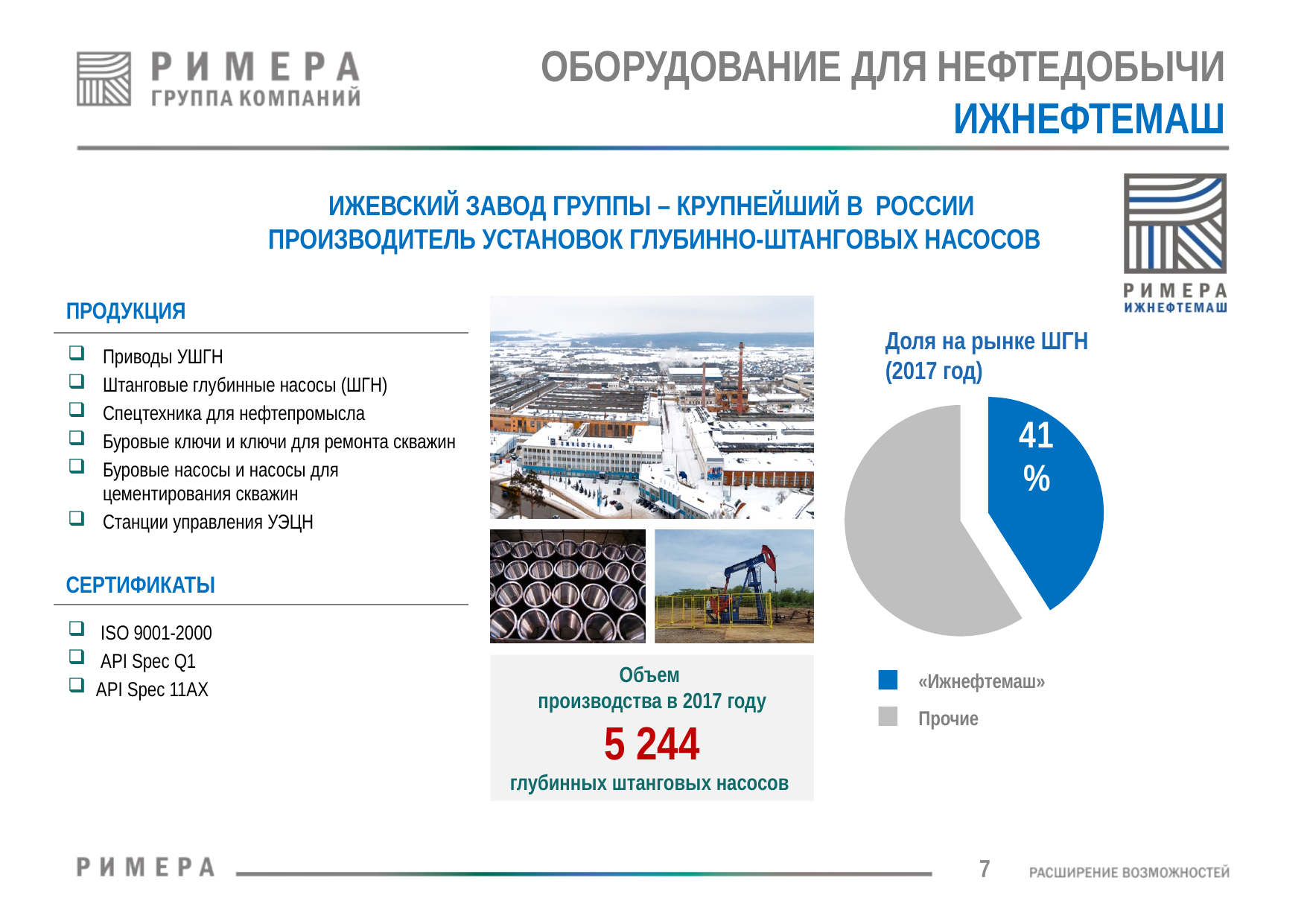
Which slice of the pie chart is larger, «Ижнефтемаш» or «Прочие»? Прочие How many slices does the pie chart «Доля на рынке ШГН» have? 2 Which category has the largest slice in the pie chart? Прочие What colour is the «Ижнефтемаш» slice in the pie chart? blue What is the title of the pie chart on the slide? Доля на рынке ШГН (2017 год) Which category has the smallest slice in the pie chart? «Ижнефтемаш» How many entries does the legend of the pie chart list? 2 What kind of chart is shown under the heading «Доля на рынке ШГН (2017 год)»? pie chart What is the market share of «Ижнефтемаш» shown in the pie chart? 41%